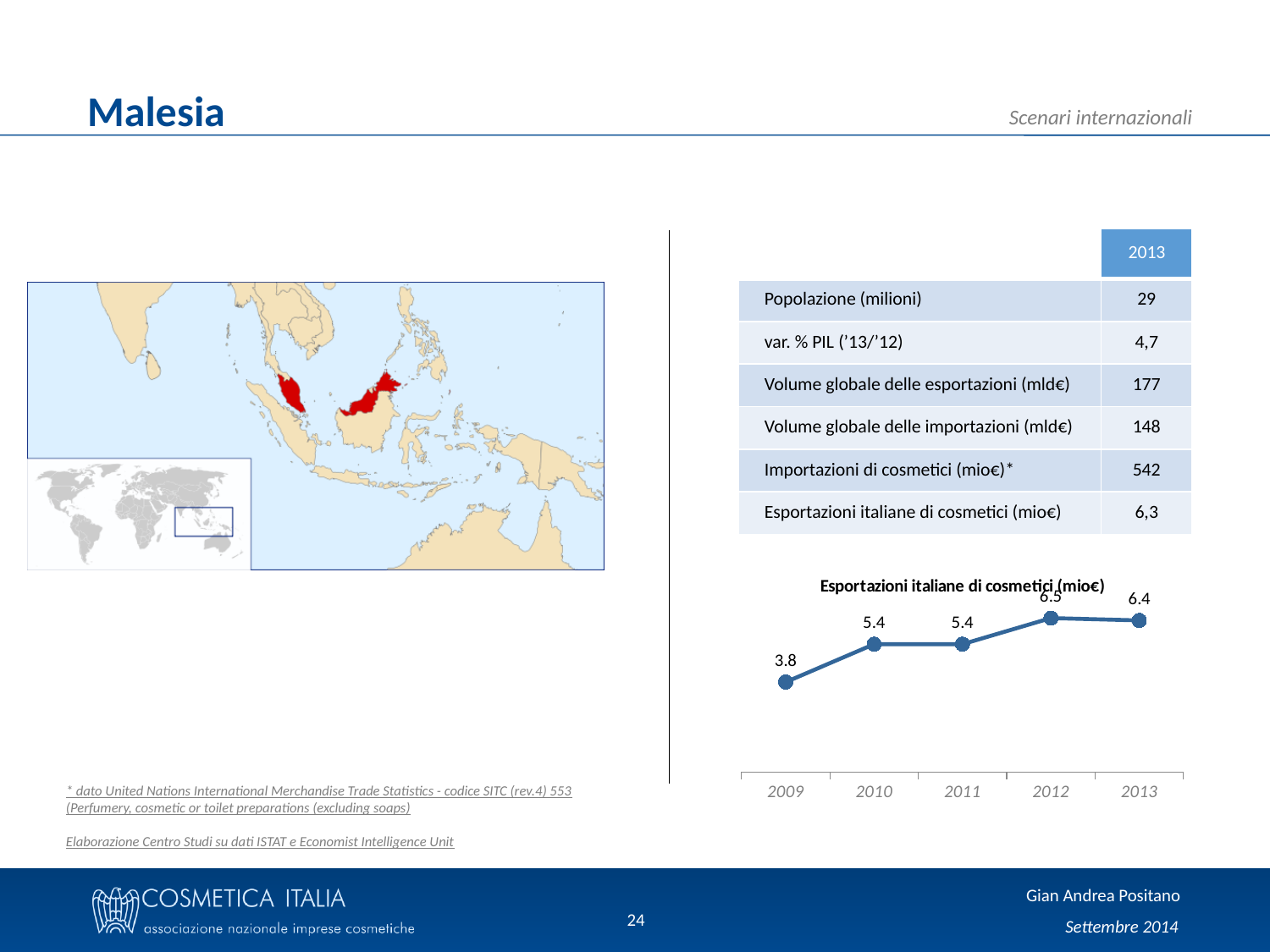
Do the values generally rise or fall from 2009 to 2013? rise Which year has the lowest value in the chart? 2009 Which year has the highest value in the chart? 2012 What is the title of the chart? Esportazioni italiane di cosmetici (mio€) What is the value for 2009 in the chart? 3.8 How many years are plotted on the x axis of the chart? 5 What type of chart is shown on the slide? line chart What is the value for 2013 in the chart? 6.4 What is the value for 2010 in the chart? 5.4 What is the difference between the values for 2012 and 2009? 2.7 What is the value for 2012 in the chart? 6.5 Which is larger, the value for 2011 or the value for 2013? 2013